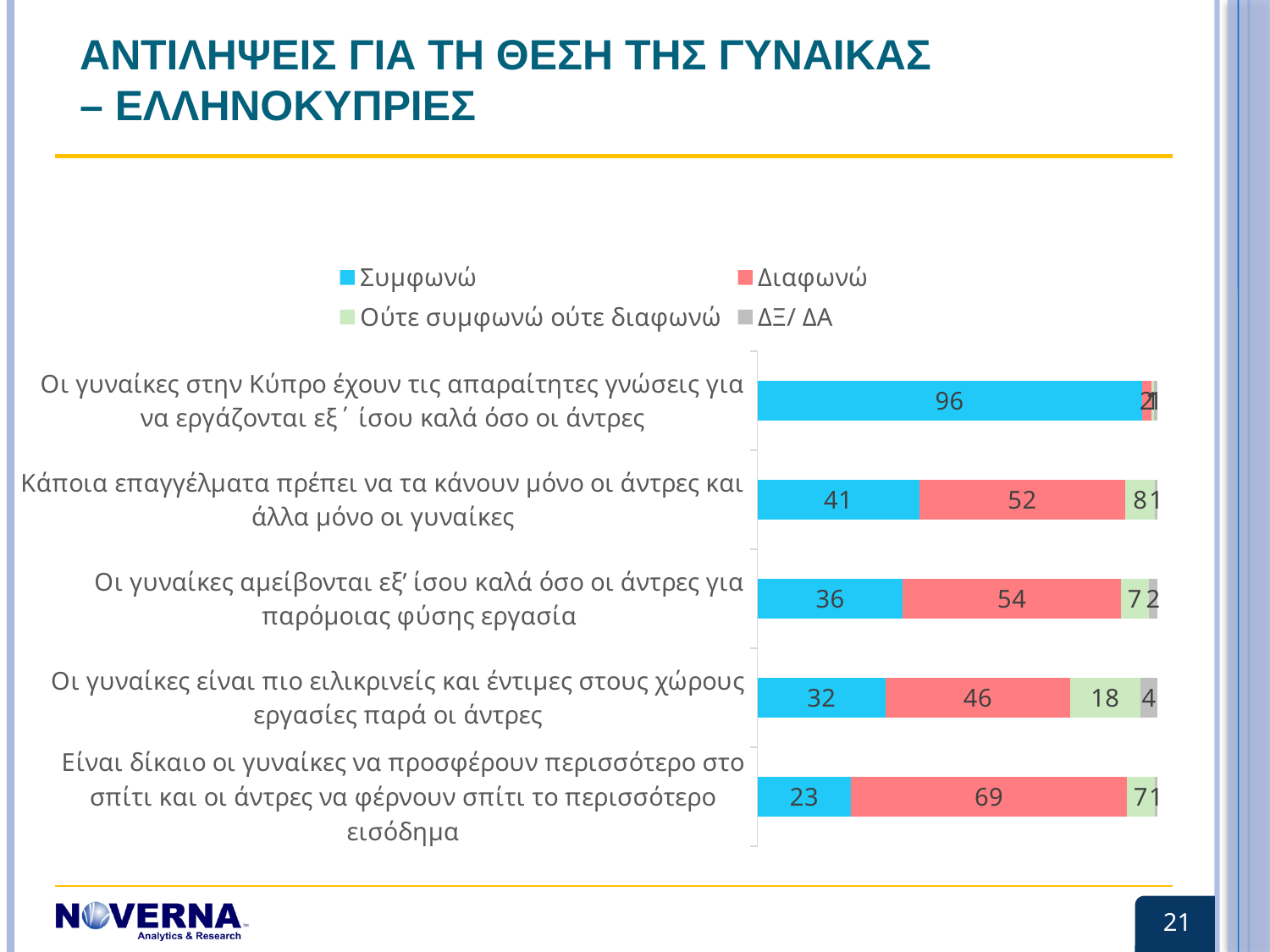
What is the total of the stacked bar for 'Οι γυναίκες είναι πιο ειλικρινείς και έντιμες στους χώρους εργασίες παρά οι άντρες' (32 + 46 + 18 + 4)? 100 How many statements (categories) are plotted in the chart? 5 Which is larger: the Συμφωνώ value for 'Κάποια επαγγέλματα πρέπει να τα κάνουν μόνο οι άντρες...' or the Συμφωνώ value for 'Οι γυναίκες αμείβονται εξ’ ίσου καλά όσο οι άντρες...'? Κάποια επαγγέλματα πρέπει να τα κάνουν μόνο οι άντρες και άλλα μόνο οι γυναίκες What is the difference between the Διαφωνώ value for 'Είναι δίκαιο οι γυναίκες να προσφέρουν περισσότερο στο σπίτι...' (69) and the Διαφωνώ value for 'Οι γυναίκες είναι πιο ειλικρινείς και έντιμες...' (46)? 23 What is the Διαφωνώ value for the statement 'Είναι δίκαιο οι γυναίκες να προσφέρουν περισσότερο στο σπίτι και οι άντρες να φέρνουν σπίτι το περισσότερο εισόδημα'? 69 What is the Συμφωνώ value for the statement 'Οι γυναίκες στην Κύπρο έχουν τις απαραίτητες γνώσεις για να εργάζονται εξ΄ ίσου καλά όσο οι άντρες'? 96 Which statement has the highest Συμφωνώ value? Οι γυναίκες στην Κύπρο έχουν τις απαραίτητες γνώσεις για να εργάζονται εξ΄ ίσου καλά όσο οι άντρες What is the Ούτε συμφωνώ ούτε διαφωνώ value for the statement 'Οι γυναίκες είναι πιο ειλικρινείς και έντιμες στους χώρους εργασίες παρά οι άντρες'? 18 What type of chart is shown on the slide? Stacked bar chart What is the Διαφωνώ value for the statement 'Κάποια επαγγέλματα πρέπει να τα κάνουν μόνο οι άντρες και άλλα μόνο οι γυναίκες'? 52 Which statement has the lowest Συμφωνώ value? Είναι δίκαιο οι γυναίκες να προσφέρουν περισσότερο στο σπίτι και οι άντρες να φέρνουν σπίτι το περισσότερο εισόδημα How many series does the legend list? 4